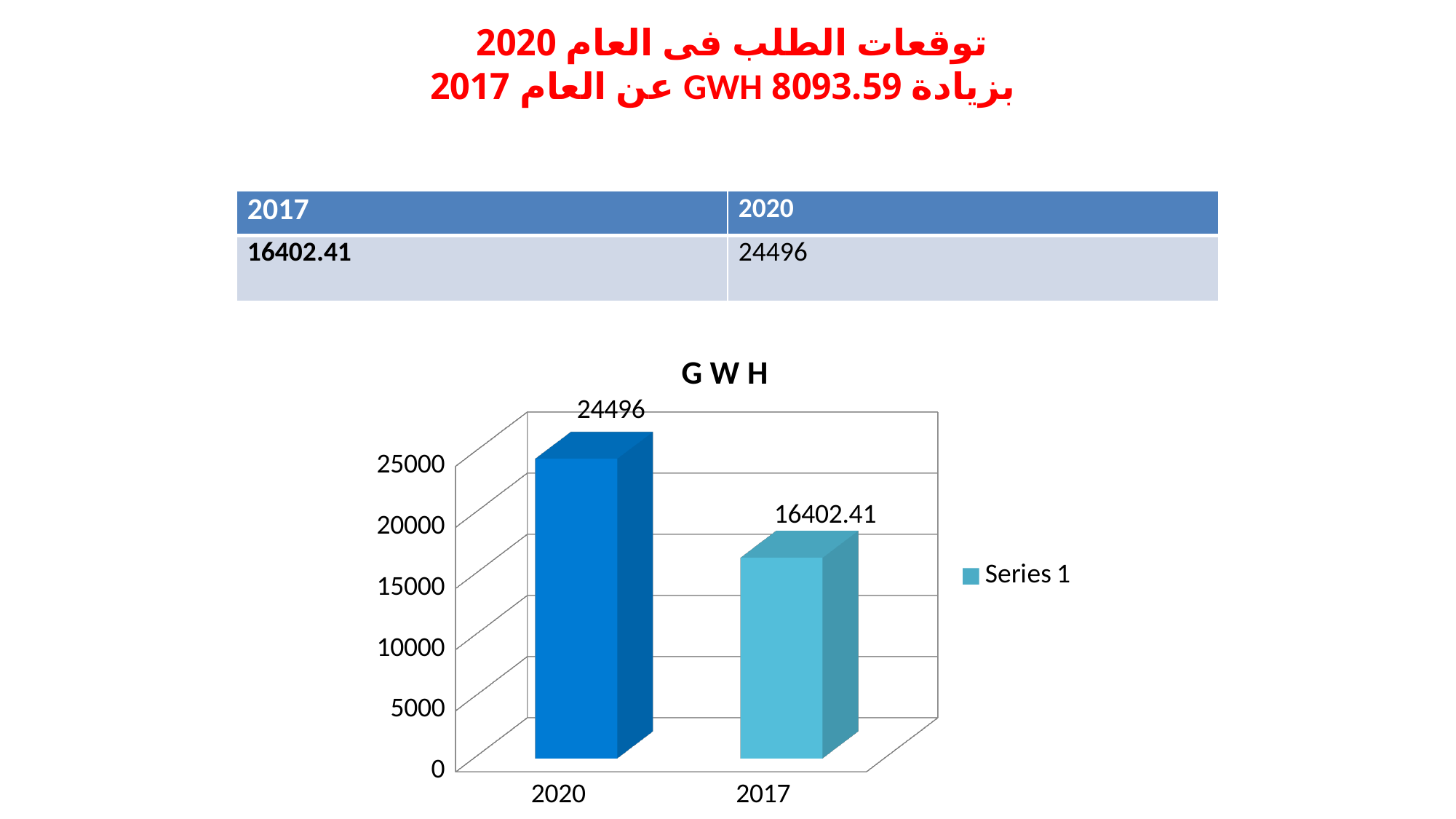
Is the value for 2017 in the GWH chart greater or less than 20000? less Which category has the lowest value in the GWH chart? 2017 What is the value for 2017 in the GWH chart? 16402.41 What is the difference between the 2020 and 2017 values in the GWH chart? 8093.59 How many series does the legend of the GWH chart list? 1 What is the title of the chart on the slide? G W H Which category has the highest value in the GWH chart? 2020 What is the value for 2020 in the GWH chart? 24496 Is the value for 2020 in the GWH chart greater or less than 20000? greater Which is larger in the GWH chart, the value for 2020 or the value for 2017? 2020 What kind of chart is shown on the slide? bar chart How many categories are shown in the GWH chart? 2